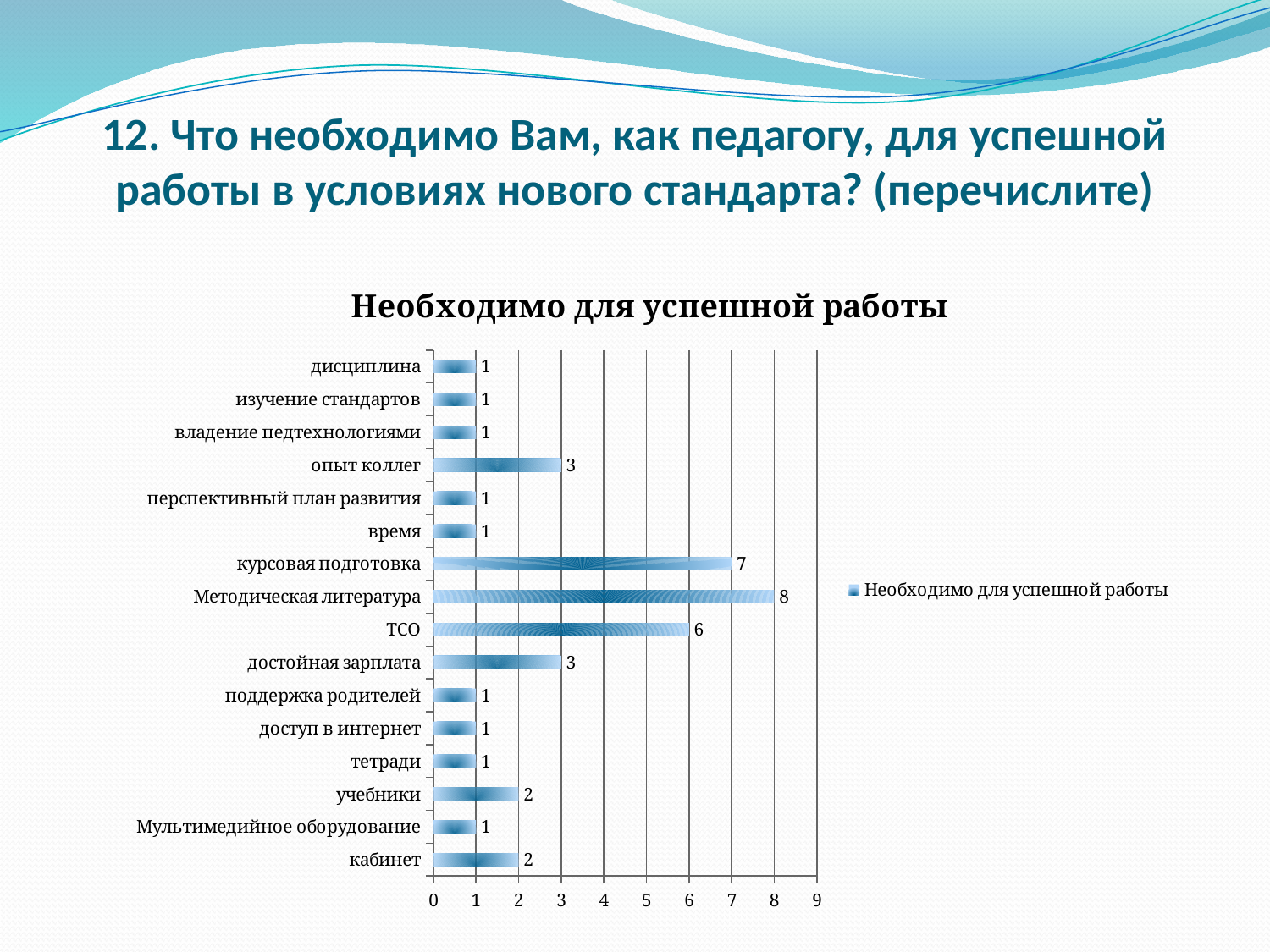
What is the difference between the values for Методическая литература and ТСО? 2 What is the value for курсовая подготовка? 7 What is the difference between the values for опыт коллег and кабинет? 1 What is the value for Методическая литература? 8 How many categories are shown on the chart? 16 What is the value for ТСО? 6 What kind of chart is shown? bar chart Which is larger, the value for курсовая подготовка or the value for достойная зарплата? курсовая подготовка What is the title of the chart? Необходимо для успешной работы What is the value for учебники? 2 Which category has the highest value? Методическая литература How many series does the legend list? 1